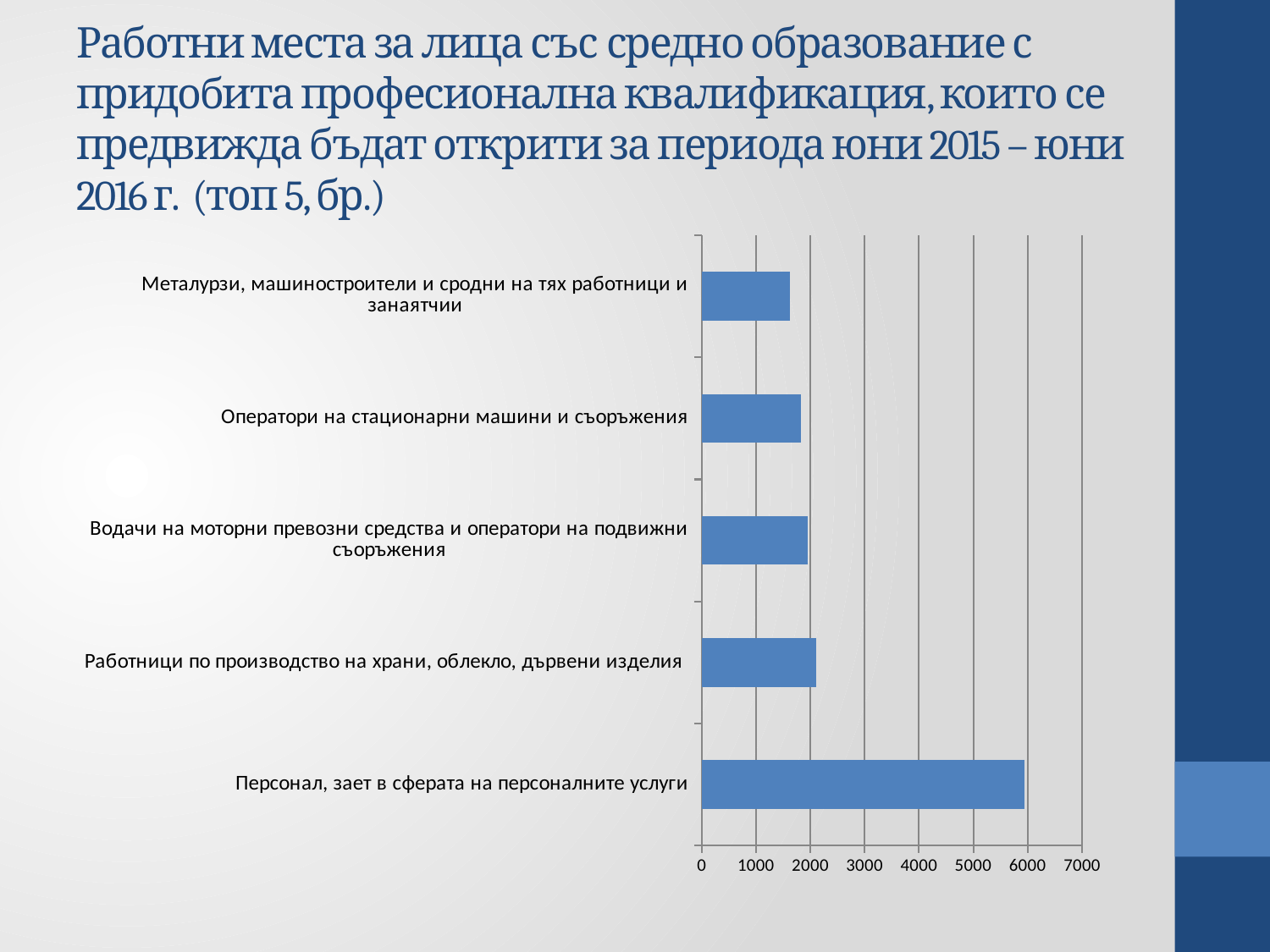
Which has a larger value: 'Водачи на моторни превозни средства и оператори на подвижни съоръжения' or 'Персонал, зает в сферата на персоналните услуги'? Персонал, зает в сферата на персоналните услуги How many categories are shown in the chart? 5 What colour are the bars in the chart? blue Is the value for 'Персонал, зает в сферата на персоналните услуги' greater or less than 5000? greater Is the value for 'Металурзи, машиностроители и сродни на тях работници и занаятчии' greater or less than 1000? greater What kind of chart is shown on the slide? bar chart Is the value for 'Металурзи, машиностроители и сродни на тях работници и занаятчии' greater or less than 2000? less Which category has the highest value in the chart? Персонал, зает в сферата на персоналните услуги What is the maximum value shown on the horizontal axis of the chart? 7000 Which has a larger value: 'Персонал, зает в сферата на персоналните услуги' or 'Работници по производство на храни, облекло, дървени изделия'? Персонал, зает в сферата на персоналните услуги